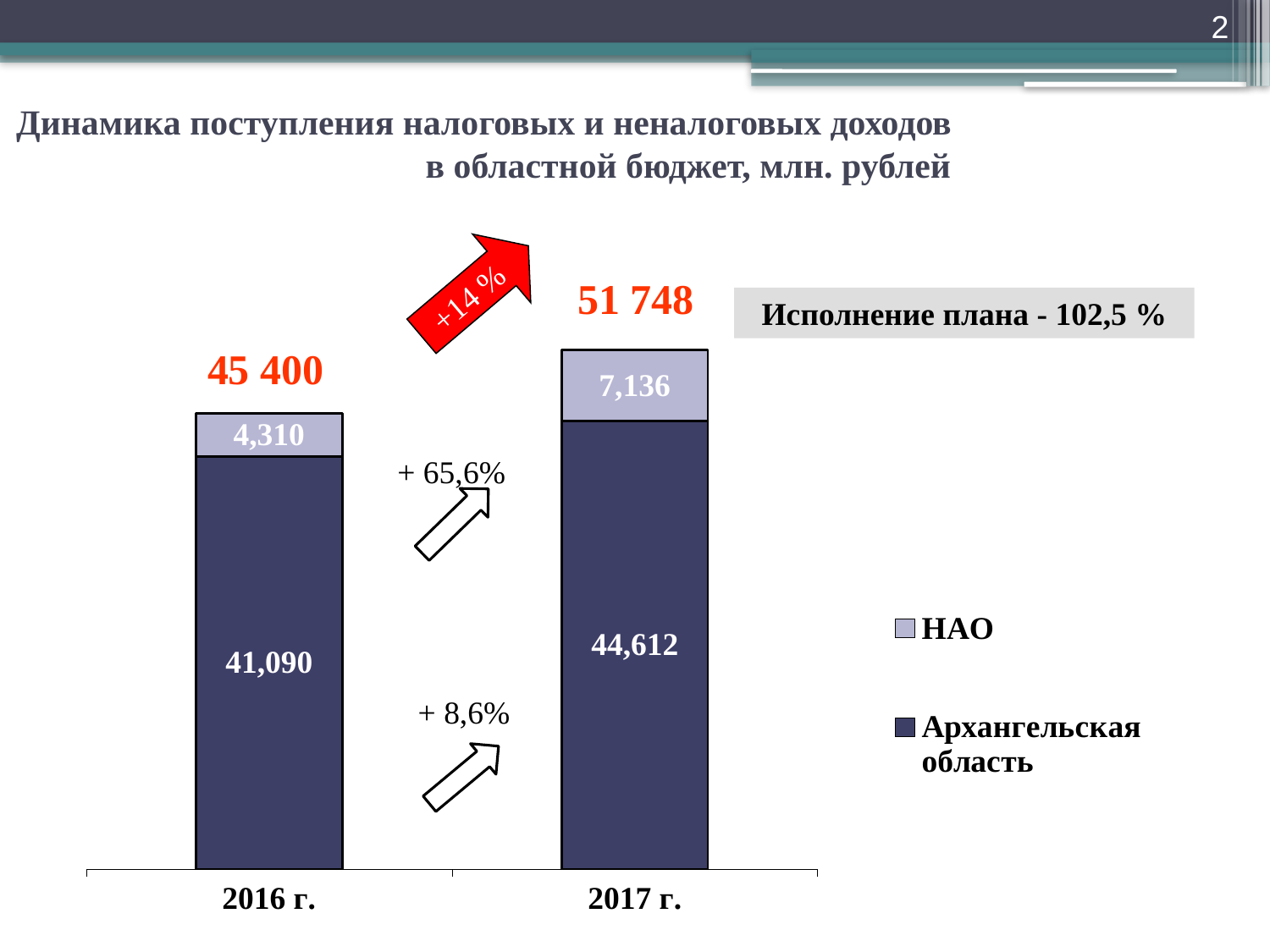
What is the value for Архангельская область in 2016 г.? 41,090 What kind of chart is shown on the slide? Stacked bar chart How many categories are shown on the x axis? 2 What is the difference between the НАО values for 2017 г. and 2016 г.? 2,826 What is the difference between the Архангельская область values for 2017 г. and 2016 г.? 3,522 What is the total of the stacked bar for 2016 г.? 45 400 What is the value for НАО in 2016 г.? 4,310 Which year has the higher value for НАО, 2016 г. or 2017 г.? 2017 г. What is the value for Архангельская область in 2017 г.? 44,612 What is the value for НАО in 2017 г.? 7,136 How many series does the legend list? 2 What is the total of the stacked bar for 2017 г.? 51 748